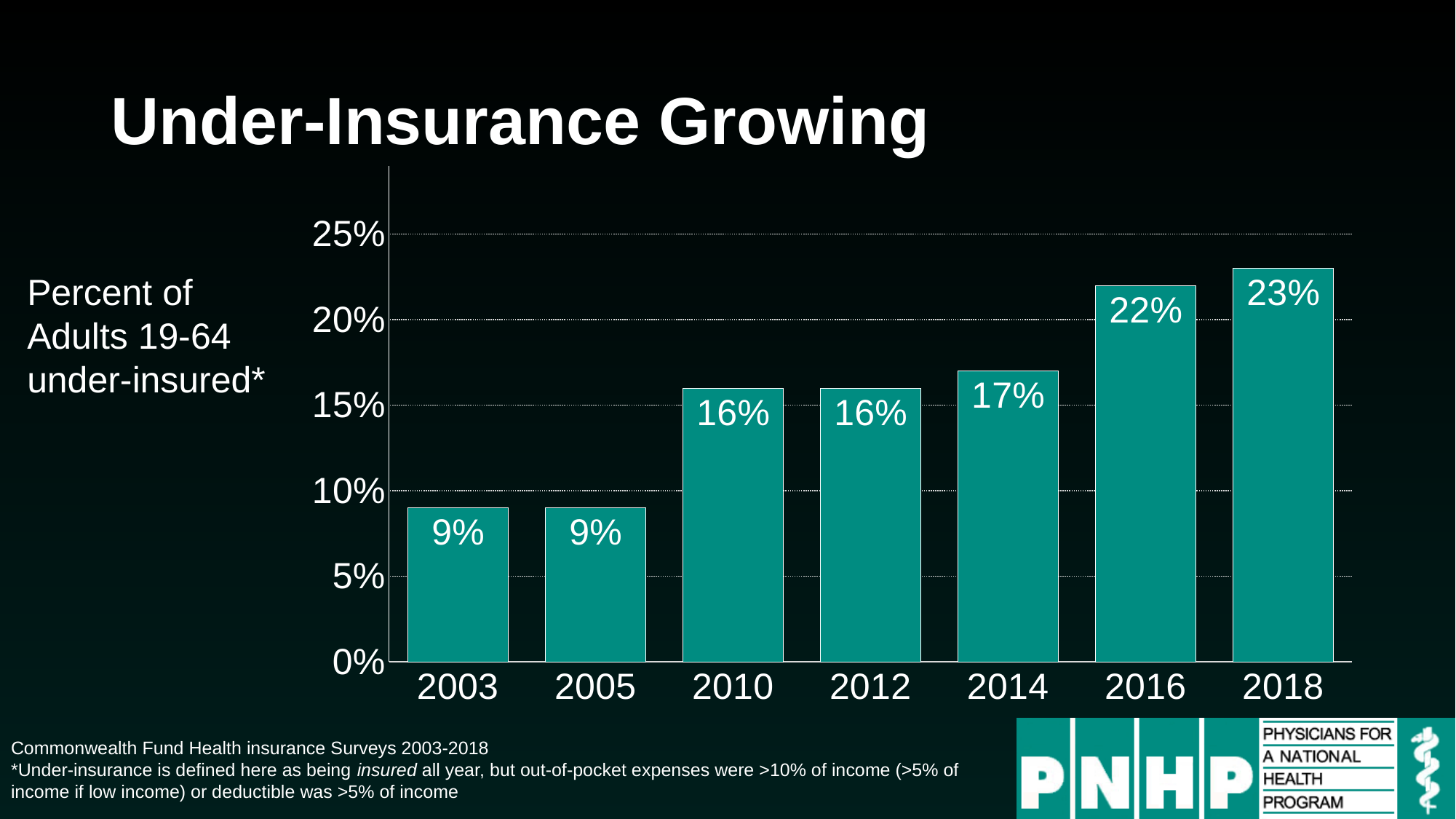
What kind of chart is shown on the slide? Bar chart What is the title of the slide? Under-Insurance Growing Is the value for 2016 greater or less than 20%? greater What percent of adults 19-64 were under-insured in 2003? 9% What is the difference between the values for 2018 and 2003? 14% What is the value shown for 2014? 17% What is the value shown for 2018? 23% Which is larger, the value for 2010 or the value for 2016? 2016 Which year has the highest percentage of under-insured adults? 2018 Do the values generally rise or fall from 2003 to 2018? Rise How many years are shown on the x axis? 7 What is the difference between the values for 2016 and 2014? 5%